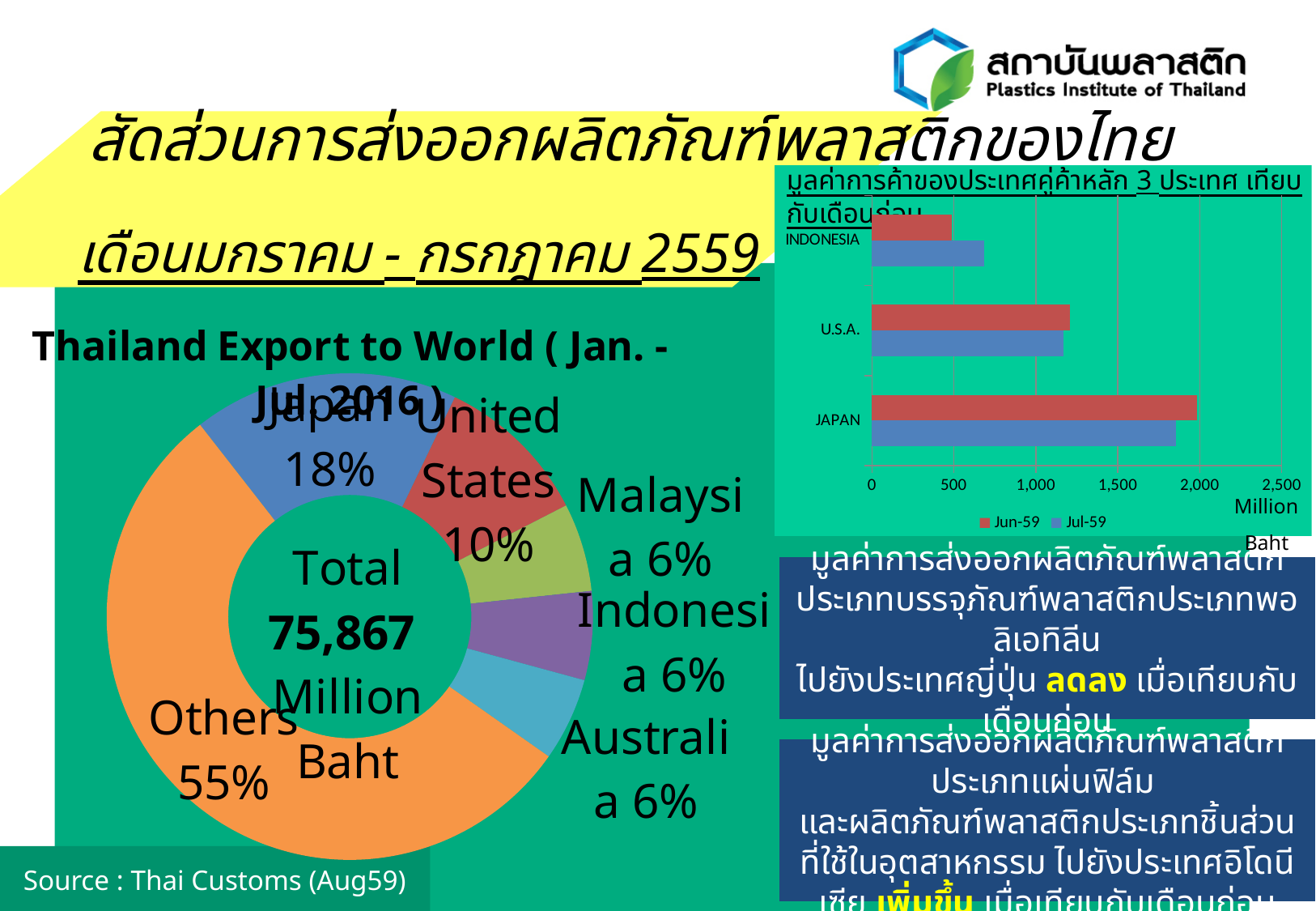
What kind of chart is 'Thailand Export to World (Jan. - Jul 2016)'? Doughnut (pie) chart In the doughnut chart 'Thailand Export to World (Jan. - Jul 2016)', what share of exports goes to Japan? 18% In the doughnut chart 'Thailand Export to World (Jan. - Jul 2016)', what share is labelled 'Others'? 55% In the bar chart on the right, how many series does the legend list? 2 In the doughnut chart 'Thailand Export to World (Jan. - Jul 2016)', how many percentage points larger is Japan's share than the United States' share? 8% In the bar chart on the right, is the Jun-59 value for INDONESIA greater or less than 1,000? less In the bar chart on the right, which country has the highest Jun-59 value? JAPAN In the bar chart on the right, for INDONESIA, which is larger: the Jun-59 value or the Jul-59 value? Jul-59 In the bar chart on the right, is the Jun-59 value for JAPAN greater or less than 1,500? greater In the doughnut chart 'Thailand Export to World (Jan. - Jul 2016)', which slice is the largest? Others In the doughnut chart 'Thailand Export to World (Jan. - Jul 2016)', what is the total export value shown in the centre? 75,867 Million Baht In the doughnut chart 'Thailand Export to World (Jan. - Jul 2016)', how many slices are shown? 6